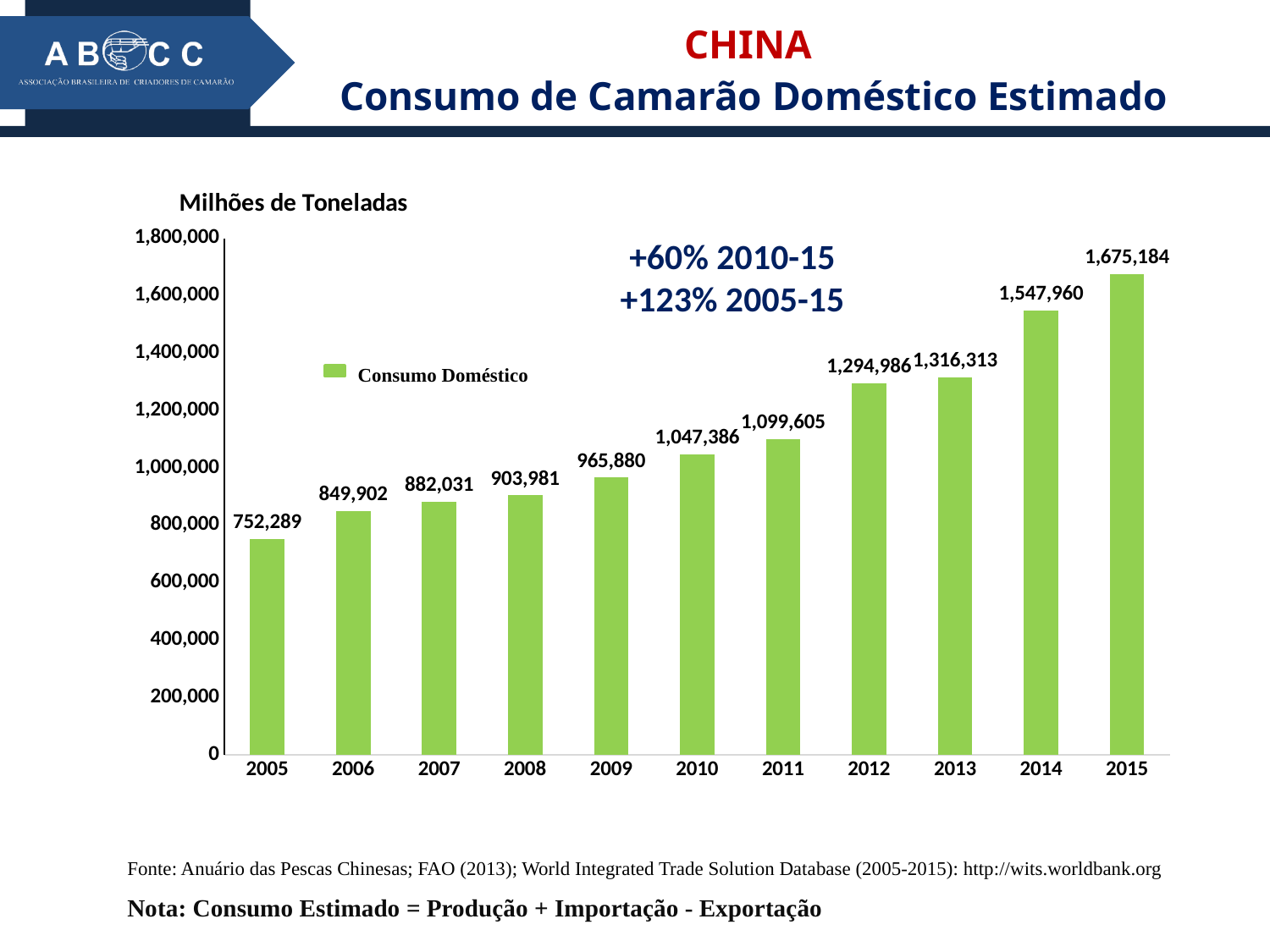
Which year has the highest consumption value? 2015 How many years are plotted on the chart? 11 What is the value shown for 2010? 1,047,386 What is the estimated domestic shrimp consumption for 2005? 752,289 What is the difference between the 2010 value and the 2005 value? 295,097 Do the values rise or fall from 2005 to 2015? Rise What is the value shown for 2013? 1,316,313 Which is larger, the value for 2008 or the value for 2009? 2009 What is the difference between the 2015 value and the 2014 value? 127,224 How many series does the legend list? 1 Which year has the lowest consumption value? 2005 What kind of chart is shown on the slide? Bar chart